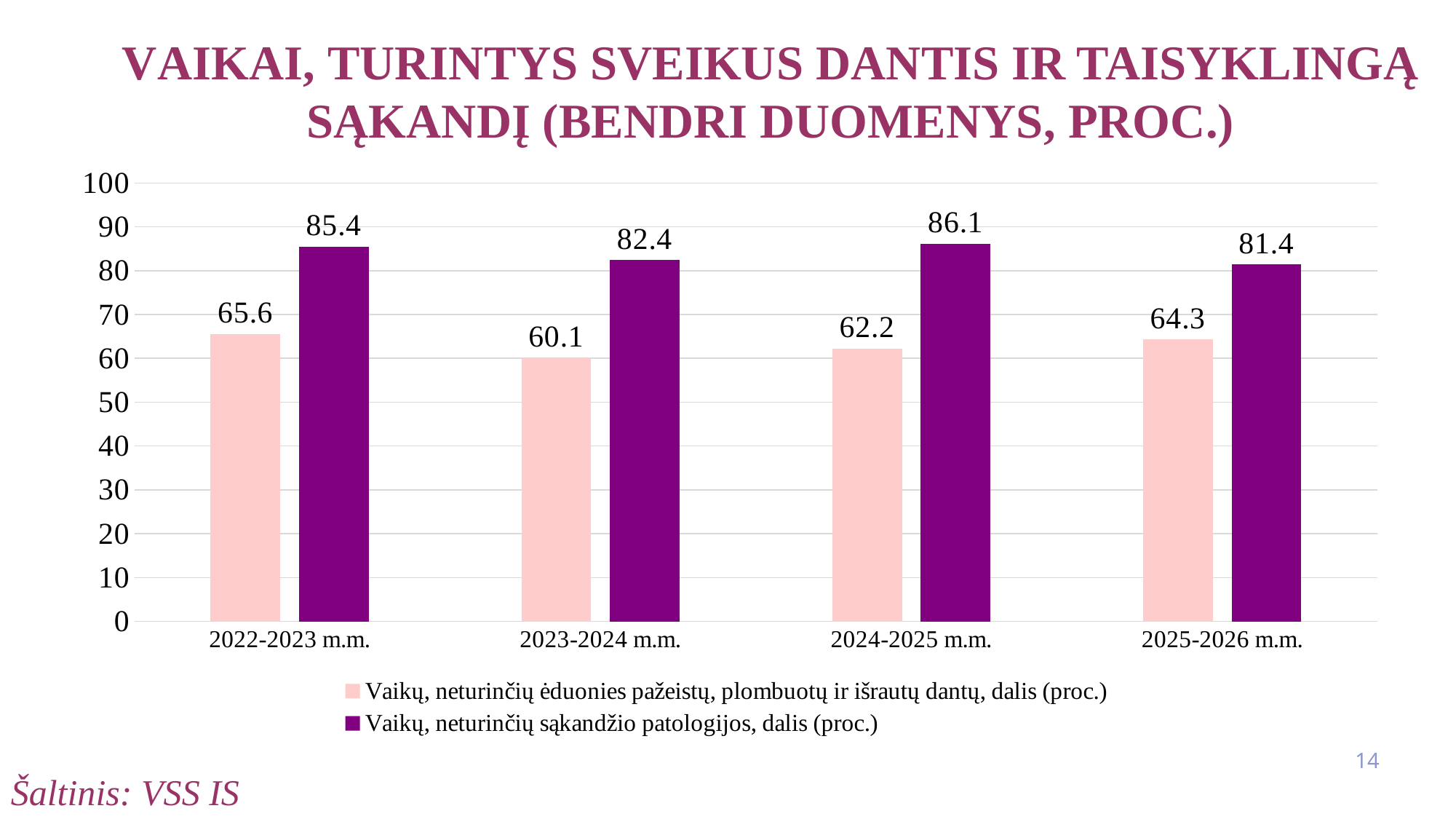
How many school years are shown on the x axis? 4 In which school year is 'Vaikų, neturinčių sąkandžio patologijos, dalis (proc.)' highest? 2024-2025 m.m. How many series does the legend list? 2 What colour are the bars for 'Vaikų, neturinčių sąkandžio patologijos, dalis (proc.)'? Purple Which is larger: 'Vaikų, neturinčių ėduonies pažeistų, plombuotų ir išrautų dantų, dalis (proc.)' in 2022-2023 m.m. or in 2025-2026 m.m.? 2022-2023 m.m. Is the value for 'Vaikų, neturinčių sąkandžio patologijos, dalis (proc.)' in 2022-2023 m.m. greater or less than 80? greater What is the value for 'Vaikų, neturinčių sąkandžio patologijos, dalis (proc.)' in 2025-2026 m.m.? 81.4 In which school year is 'Vaikų, neturinčių ėduonies pažeistų, plombuotų ir išrautų dantų, dalis (proc.)' lowest? 2023-2024 m.m. What is the difference between the two series in 2024-2025 m.m.? 23.9 What is the value for 'Vaikų, neturinčių sąkandžio patologijos, dalis (proc.)' in 2023-2024 m.m.? 82.4 What is the value for 'Vaikų, neturinčių ėduonies pažeistų, plombuotų ir išrautų dantų, dalis (proc.)' in 2022-2023 m.m.? 65.6 What kind of chart is shown on the slide? Bar chart